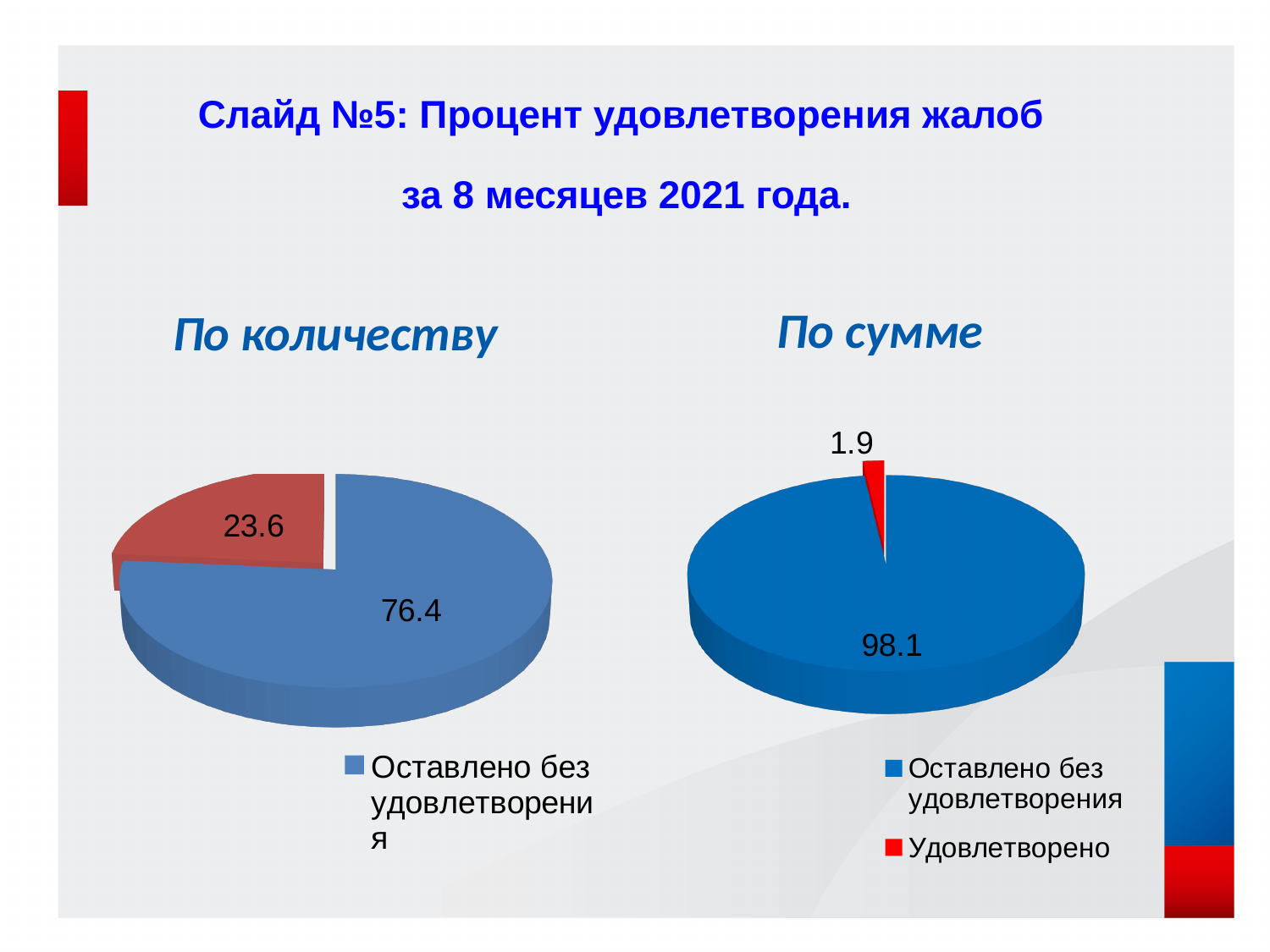
In the left chart titled "По количеству", what value is shown for the slice labelled "Оставлено без удовлетворения"? 76.4 What kind of chart is the chart titled "По количеству"? Pie chart How many entries does the legend of the chart titled "По сумме" list? 2 In the right chart titled "По сумме", what value is shown for "Удовлетворено"? 1.9 How many slices does the chart titled "По сумме" have? 2 In the right chart titled "По сумме", which category has the smallest slice? Удовлетворено In the left chart titled "По количеству", what is the difference between the two slice values, 76.4 and 23.6? 52.8 In the right chart titled "По сумме", what is the difference between the values 98.1 and 1.9? 96.2 In the right chart titled "По сумме", which category has the largest slice? Оставлено без удовлетворения In the right chart titled "По сумме", what value is shown for "Оставлено без удовлетворения"? 98.1 In the left chart titled "По количеству", what value is shown on the red slice? 23.6 What kind of chart is the chart titled "По сумме"? Pie chart